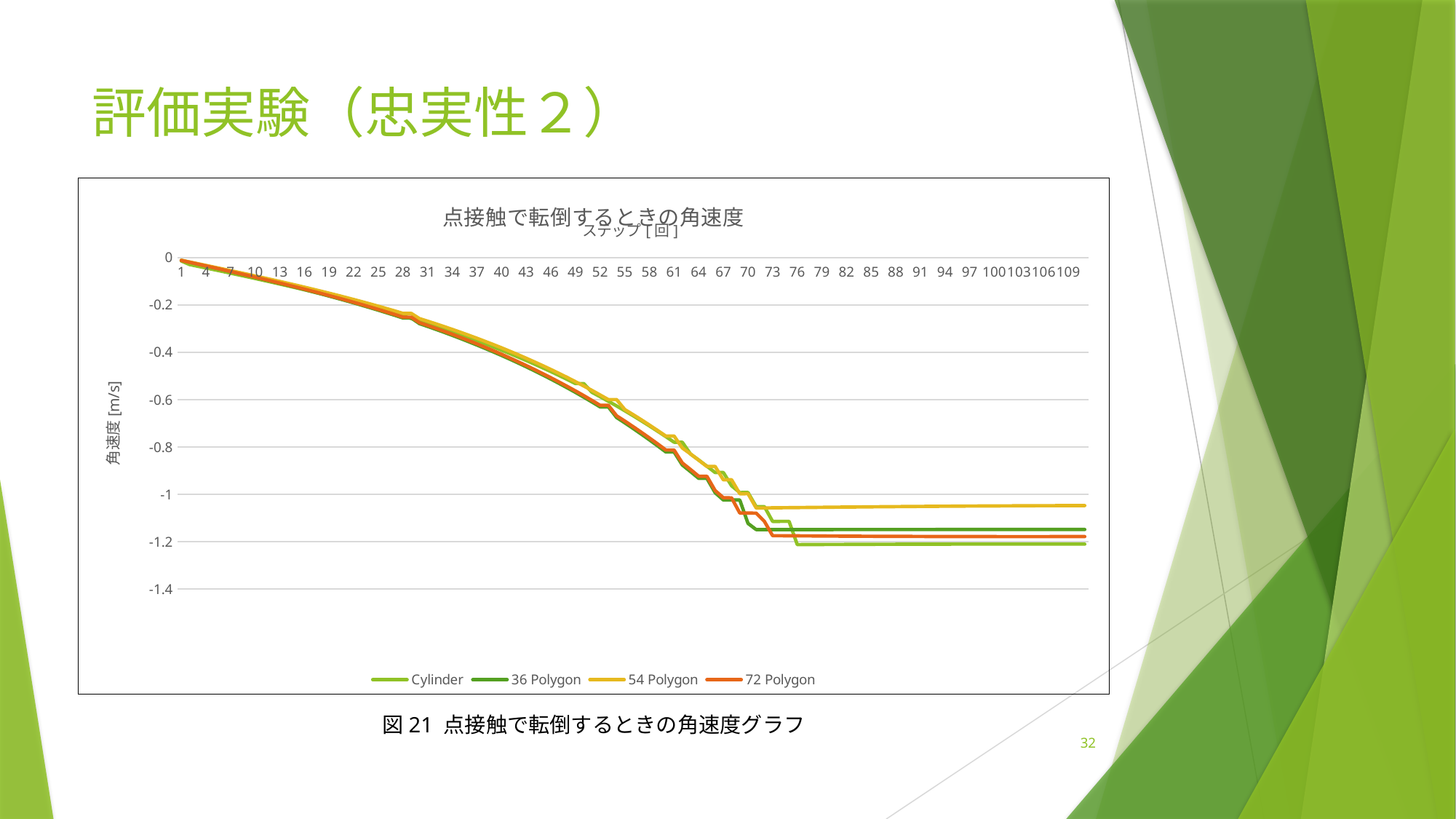
Do the values of the Cylinder series rise or fall from step 1 to step 70? fall At step 109, is the value for 54 Polygon greater or less than -1.2? greater At step 109, is the value for 54 Polygon greater or less than -1? less How many series does the legend list? 4 What is the label of the vertical axis? 角速度 [m/s] Which series has the highest (least negative) value at the final step (109)? 54 Polygon What kind of chart is shown on the slide? line chart At step 40, is the value for Cylinder greater or less than -0.6? greater What is the title of the chart? 点接触で転倒するときの角速度 Which series has the lowest (most negative) value at the final step (109)? Cylinder At step 109, which is larger, the value for 54 Polygon or the value for Cylinder? 54 Polygon